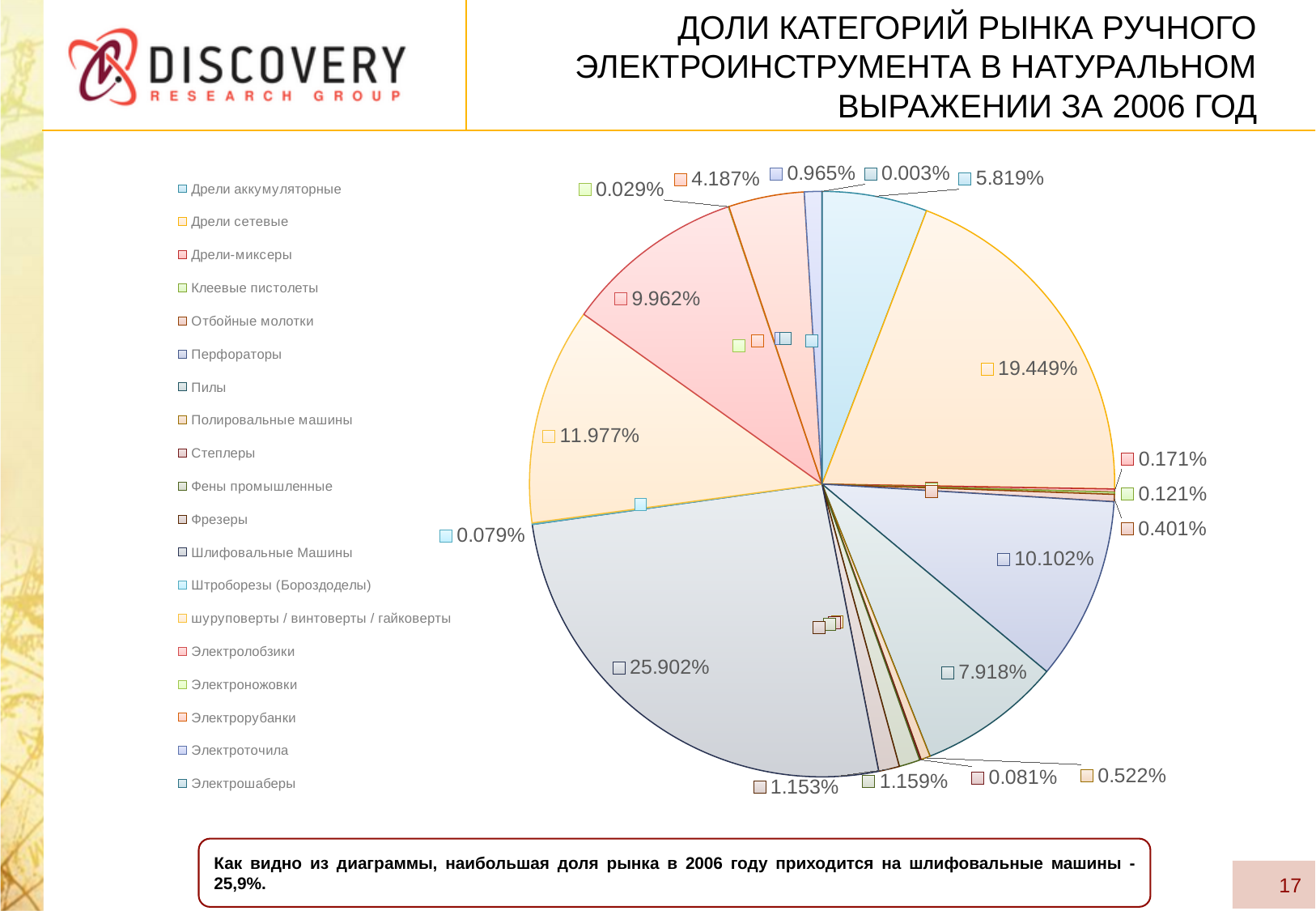
What is the share shown for шуруповерты / винтоверты / гайковерты? 11.977% What is the share shown for Перфораторы? 10.102% How many categories does the legend of the pie chart list? 19 What is the share shown for Дрели сетевые? 19.449% What kind of chart is shown on the slide? pie chart What is the share shown for Электролобзики? 9.962% Which category has the largest share of the pie chart? Шлифовальные Машины What year does the chart title say the data refers to? 2006 What is the difference in percentage points between the shares of Шлифовальные Машины and Дрели сетевые? 6.453 Which has the larger share, Перфораторы or Пилы? Перфораторы What is the share shown for Шлифовальные Машины? 25.902% What is the smallest share printed on the pie chart? 0.003%